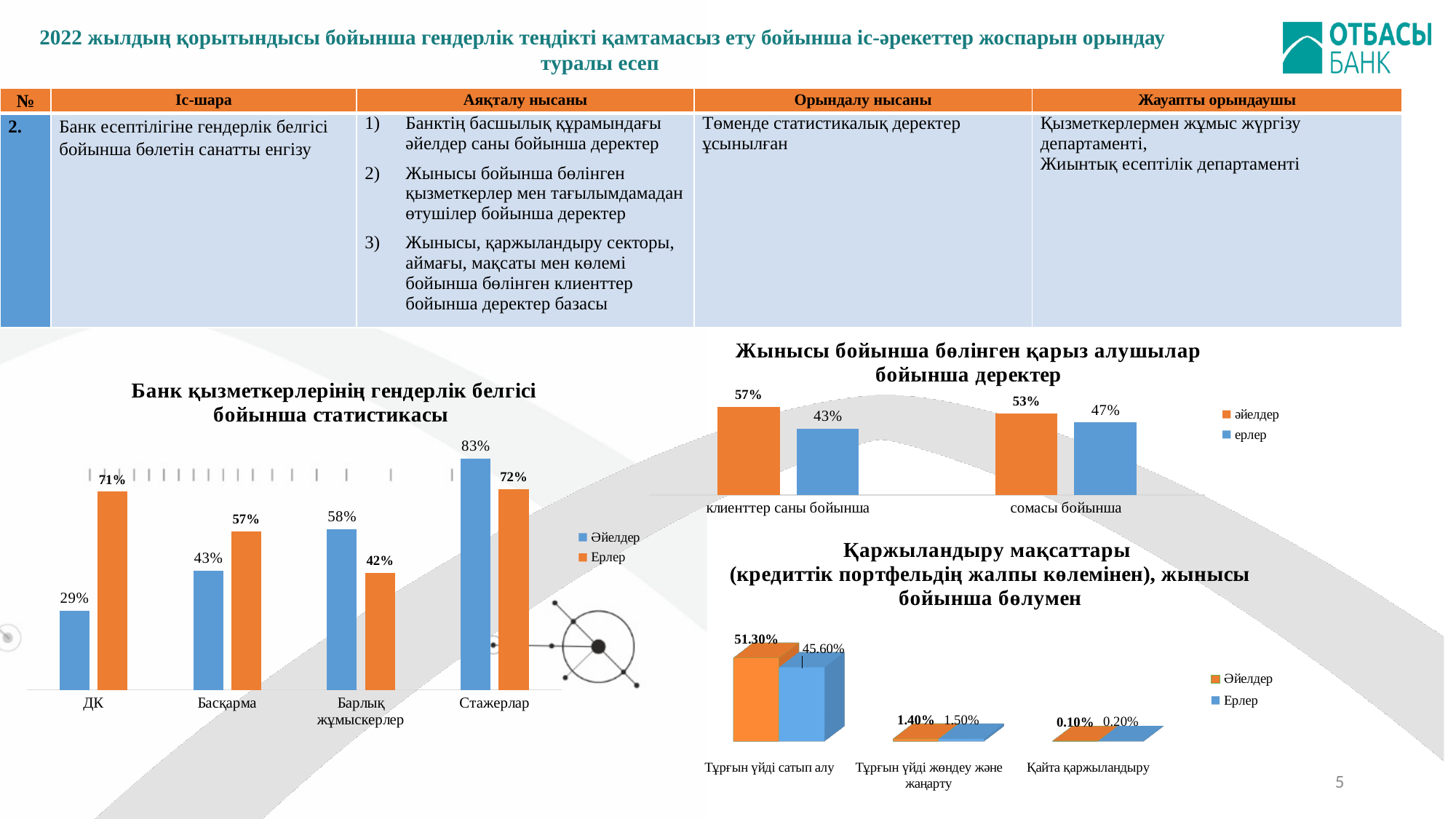
In the chart 'Банк қызметкерлерінің гендерлік белгісі бойынша статистикасы', what is the value for Ерлер in the Басқарма category? 57% In the chart 'Банк қызметкерлерінің гендерлік белгісі бойынша статистикасы', how many categories are shown on the x axis? 4 In the chart 'Банк қызметкерлерінің гендерлік белгісі бойынша статистикасы', which category has the highest Әйелдер value? Стажерлар In the chart 'Банк қызметкерлерінің гендерлік белгісі бойынша статистикасы', what is the difference between the Ерлер and Әйелдер values for ДК? 42% In the chart 'Банк қызметкерлерінің гендерлік белгісі бойынша статистикасы', what is the value for Әйелдер in the ДК category? 29% What type of chart is 'Қаржыландыру мақсаттары'? bar chart In the chart 'Жынысы бойынша бөлінген қарыз алушылар бойынша деректер', which is larger for 'сомасы бойынша': әйелдер or ерлер? әйелдер In the chart 'Жынысы бойынша бөлінген қарыз алушылар бойынша деректер', what is the value for әйелдер in the 'клиенттер саны бойынша' category? 57% In the chart 'Қаржыландыру мақсаттары', what is the value for Әйелдер in the 'Қайта қаржыландыру' category? 0.10% In the chart 'Қаржыландыру мақсаттары', which category has the lowest Ерлер value? Қайта қаржыландыру In the chart 'Жынысы бойынша бөлінген қарыз алушылар бойынша деректер', what is the difference between әйелдер and ерлер for 'сомасы бойынша'? 6% In the chart 'Қаржыландыру мақсаттары', what is the value for Ерлер in the 'Тұрғын үйді сатып алу' category? 45.60%